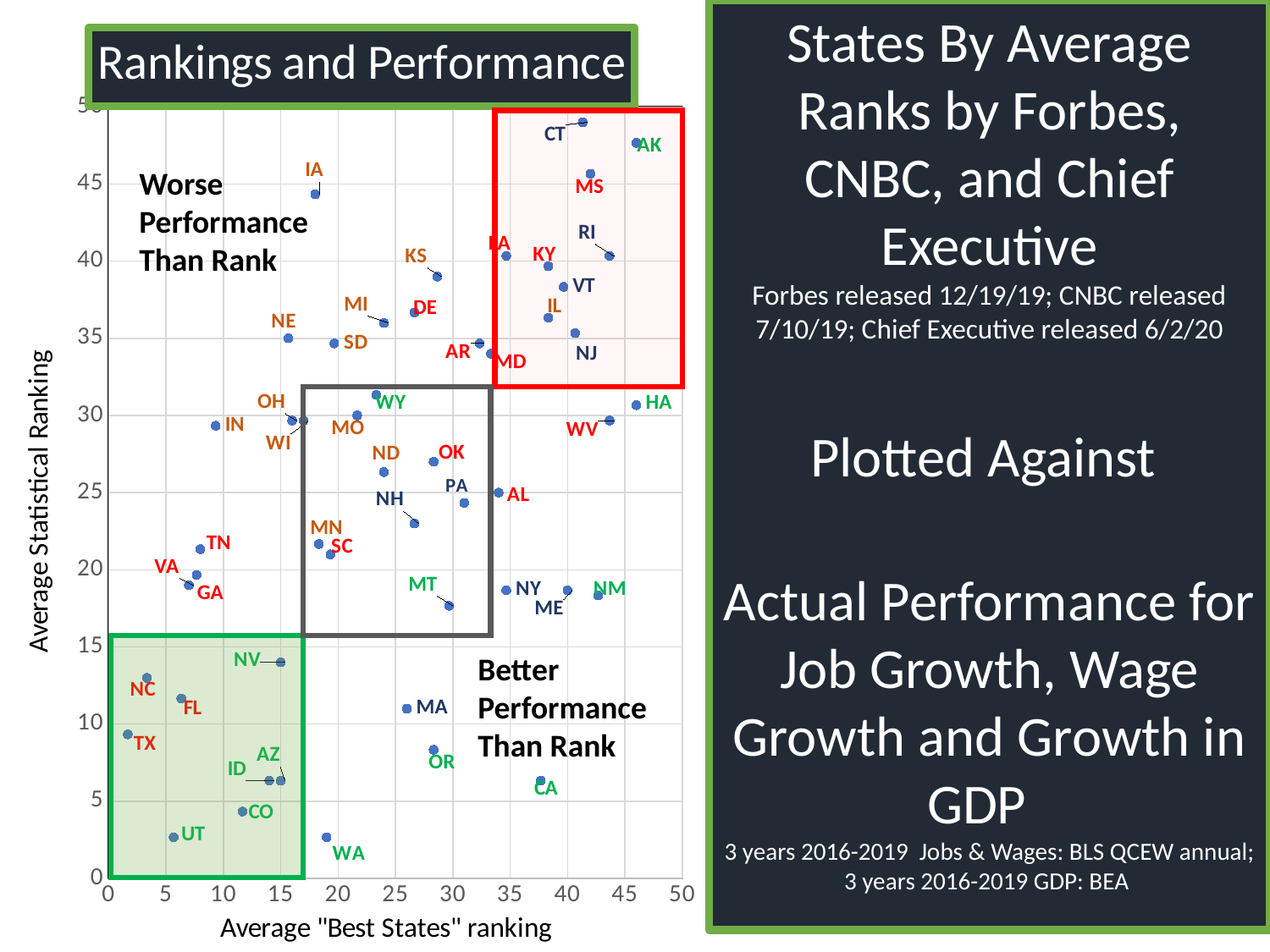
What is the title of the chart? Rankings and Performance Is the Average Statistical Ranking for MA greater or less than 15? less What is the label of the x axis of the chart? Average "Best States" ranking Which state has the highest Average Statistical Ranking on the chart? CT Is the Average "Best States" ranking for TX greater or less than 5? less What kind of chart is shown on the slide? scatter plot Is the Average Statistical Ranking for WA greater or less than 5? less Which state has a higher Average Statistical Ranking, CT or WA? CT